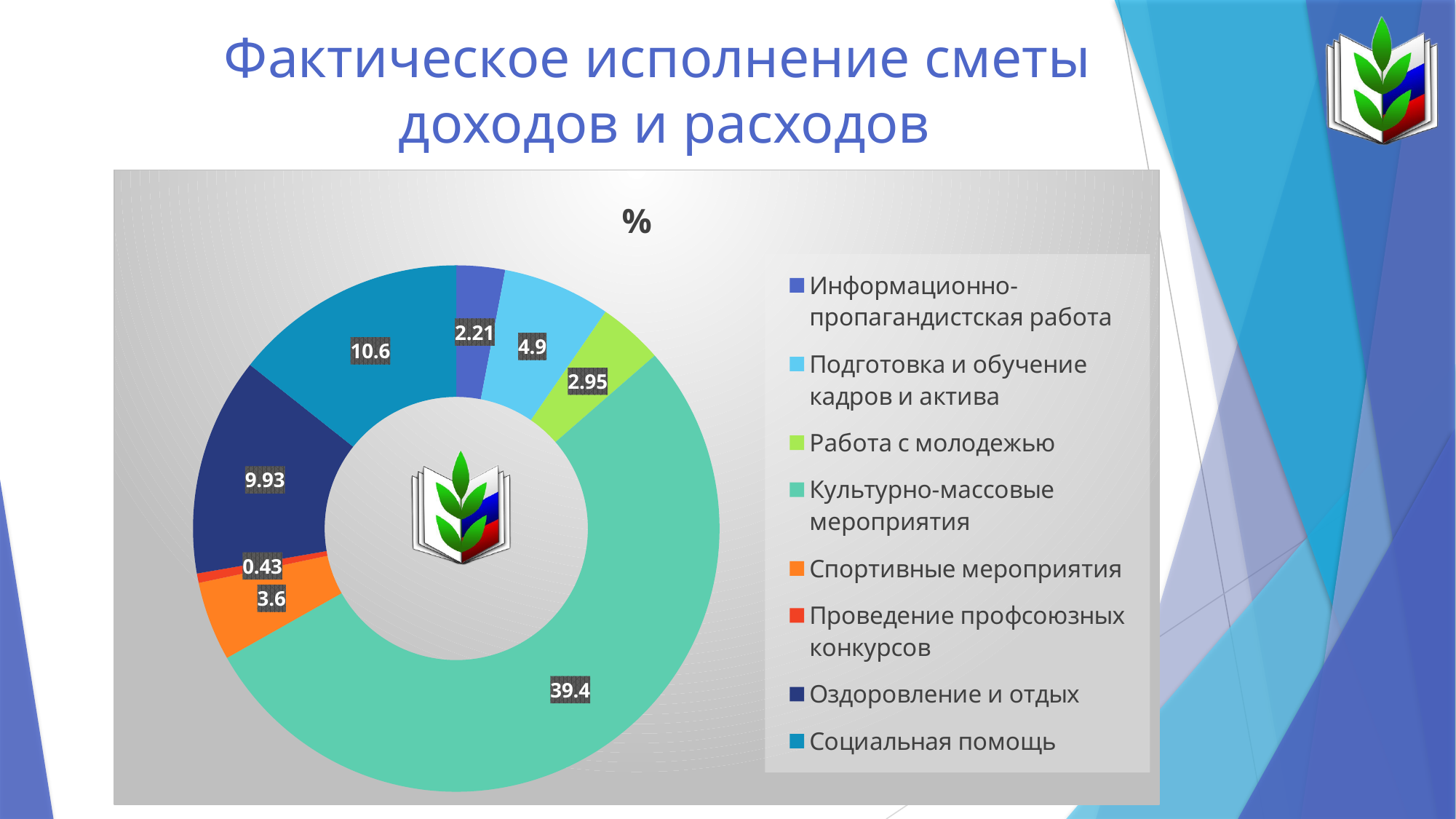
How many categories does the chart show? 8 What value is shown for Культурно-массовые мероприятия? 39.4 Which category has the smallest value? Проведение профсоюзных конкурсов What value is shown for Проведение профсоюзных конкурсов? 0.43 What value is shown for Оздоровление и отдых? 9.93 What value is shown for Социальная помощь? 10.6 Which category has the largest value? Культурно-массовые мероприятия What is the title of the chart? % What value is shown for Подготовка и обучение кадров и актива? 4.9 What is the difference between the values for Культурно-массовые мероприятия and Социальная помощь? 28.8 What kind of chart is shown on the slide? doughnut chart Which is larger: the value for Спортивные мероприятия or the value for Работа с молодежью? Спортивные мероприятия